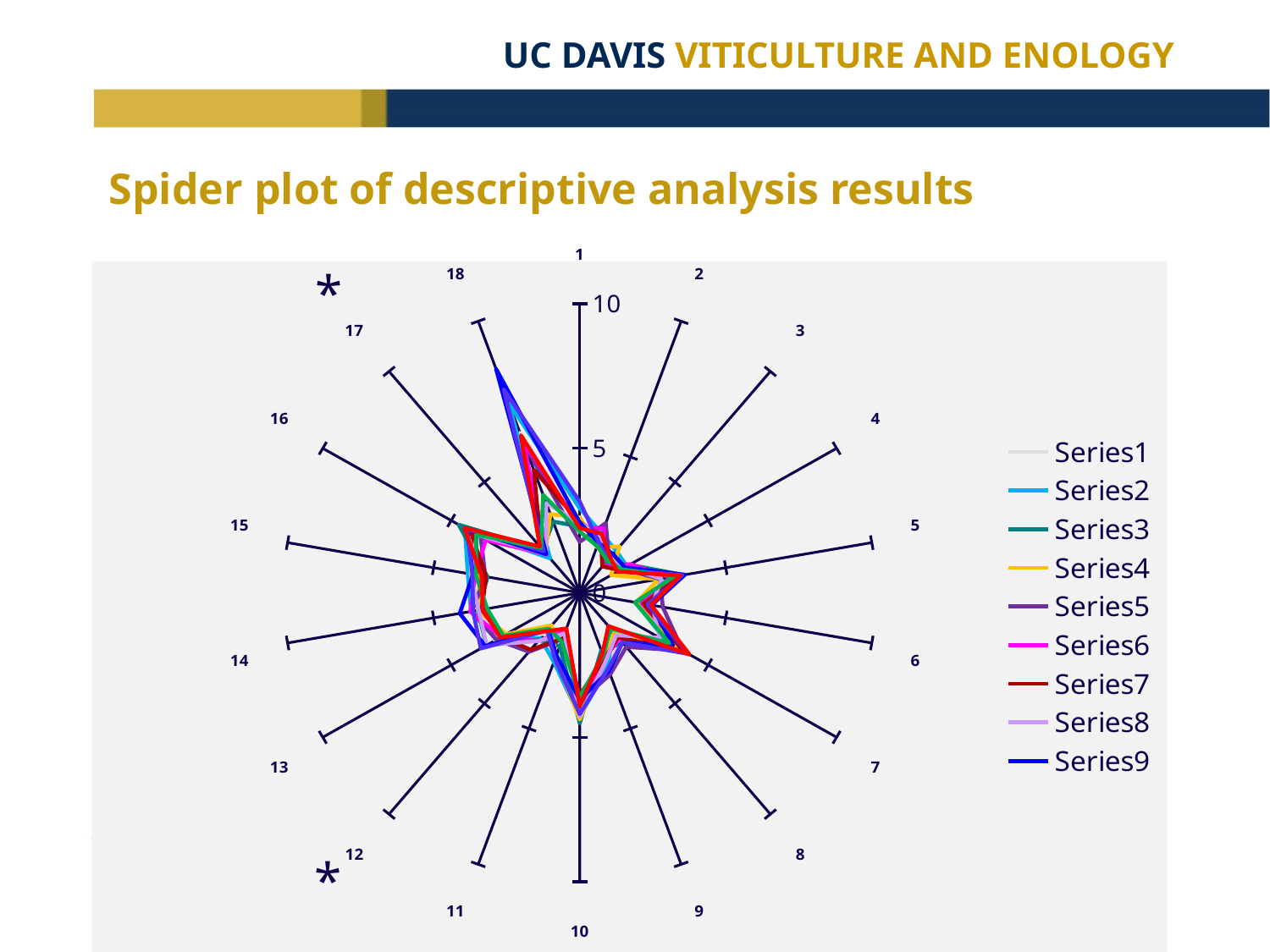
What kind of chart is shown on the slide? Radar (spider) chart What is the title of the chart on the slide? Spider plot of descriptive analysis results Is the value for category 18 for Series9 greater or less than 5? greater What is the maximum value shown on the radial axis? 10 Is the value for category 18 for Series9 greater or less than 10? less Is the value for category 13 for Series2 greater or less than 5? less Which category has the highest values across the series? 18 How many categories (axes) does the spider plot have? 18 How many series does the legend list? 9